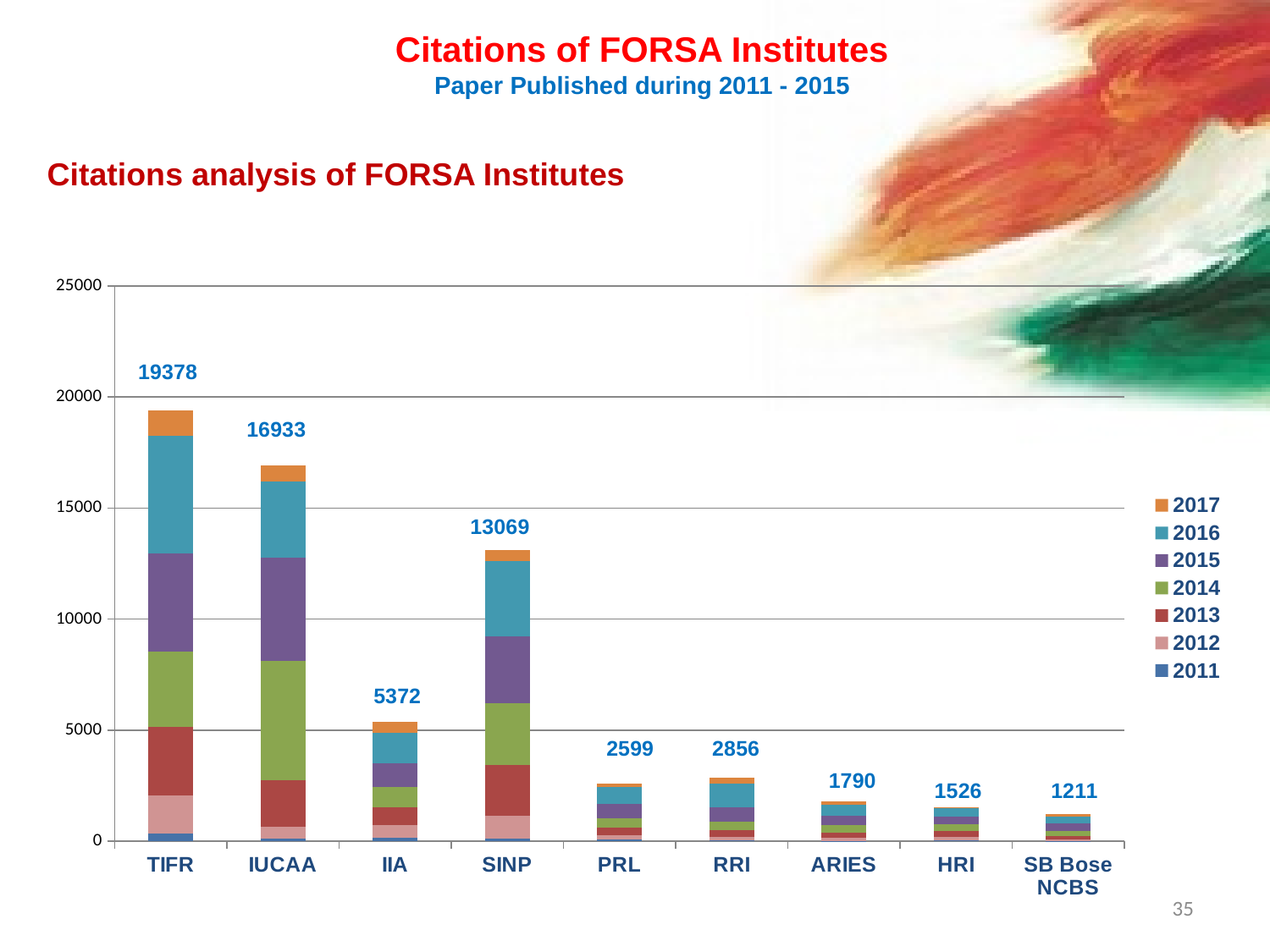
What is the difference between the total citations of TIFR and IUCAA? 2445 What is the title of the chart on the slide? Citations analysis of FORSA Institutes What kind of chart is shown on the slide? Stacked bar chart Is the total for IIA greater or less than 5000? greater Which institute has the highest total citations? TIFR What is the total number of citations for ARIES? 1790 How many series does the legend list? 7 Which has more total citations, PRL or RRI? RRI What is the total number of citations for TIFR? 19378 What is the total number of citations for SINP? 13069 How many institutes are shown on the x axis? 9 Which institute has the lowest total citations? SB Bose NCBS